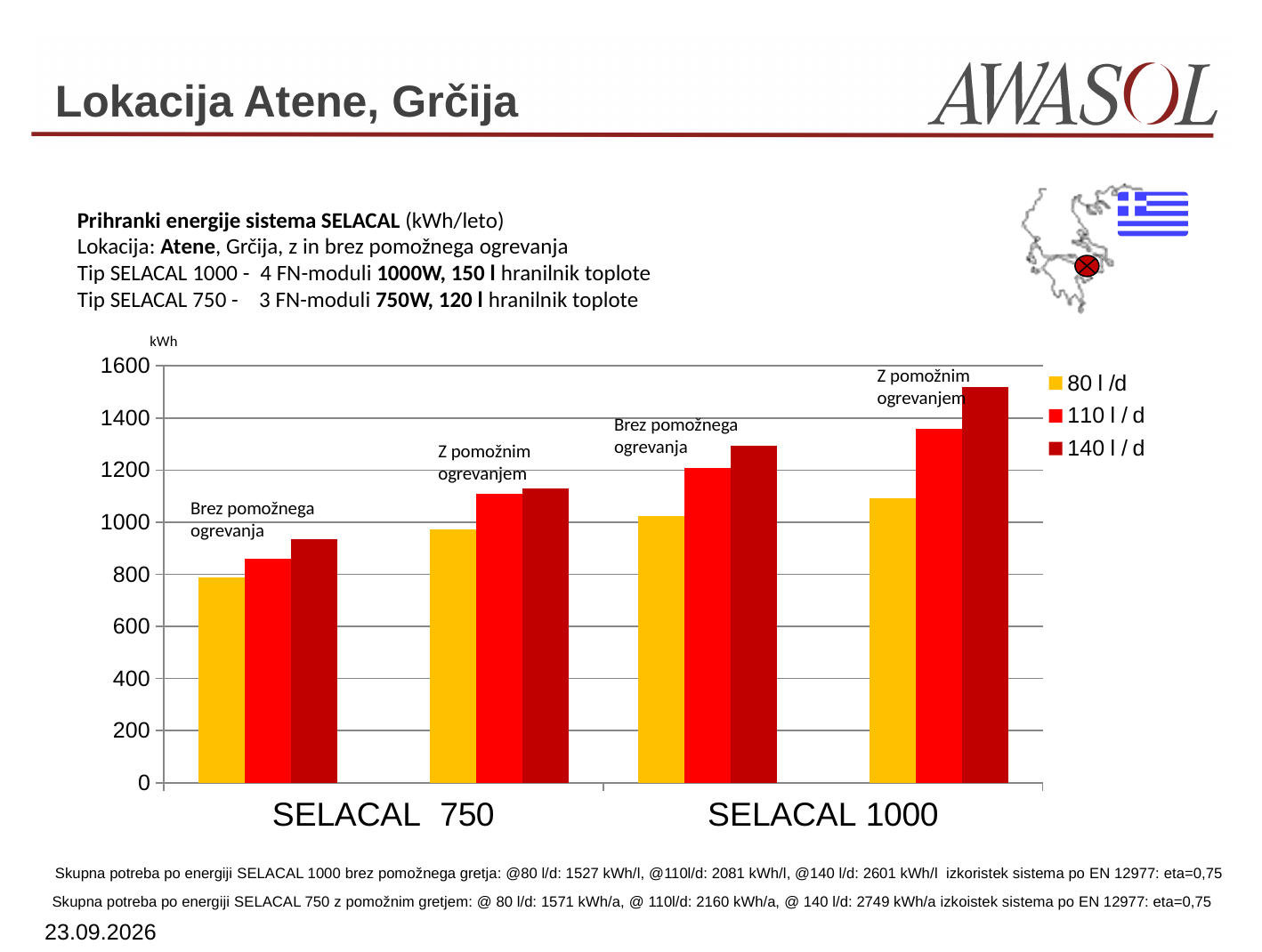
How many groups of bars are plotted in the chart? 4 Is the value for 140 l / d in the SELACAL 1000 'Brez pomožnega ogrevanja' group greater or less than 1400? less Which group of bars contains the lowest value in the chart? SELACAL 750, Brez pomožnega ogrevanja Is the value for 140 l / d in the SELACAL 750 'Brez pomožnega ogrevanja' group greater or less than 1000? less Is the value for 140 l / d in the SELACAL 1000 'Z pomožnim ogrevanjem' group greater or less than 1400? greater Do the values for the 80 l /d series rise or fall from left to right across the groups? rise What unit is shown at the top of the vertical axis? kWh Which series has the tallest bar in the chart? 140 l / d What kind of chart is shown on the slide? bar chart How many series does the legend list? 3 Within the SELACAL 1000 'Z pomožnim ogrevanjem' group, which is larger: the 80 l /d bar or the 140 l / d bar? 140 l / d